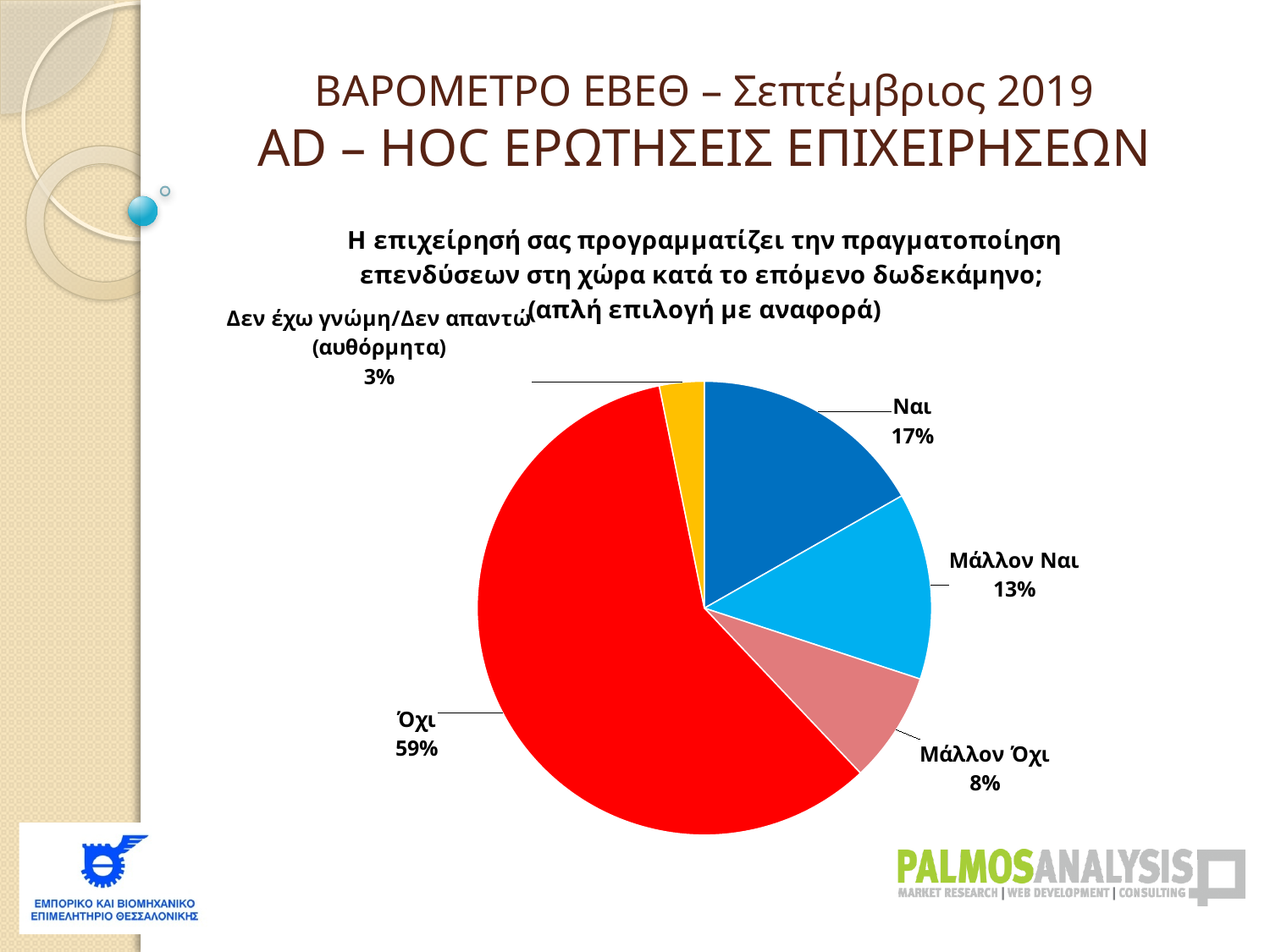
Which response has the smallest share of the pie? Δεν έχω γνώμη/Δεν απαντώ (αυθόρμητα) What percentage of respondents answered 'Μάλλον Όχι'? 8% Which response has the largest share of the pie? Όχι What is the difference in percentage points between 'Όχι' and 'Ναι'? 42 How many slices does the pie chart have? 5 What percentage of respondents answered 'Δεν έχω γνώμη/Δεν απαντώ (αυθόρμητα)'? 3% Which is larger, the share for 'Μάλλον Ναι' or the share for 'Μάλλον Όχι'? Μάλλον Ναι What colour is the 'Όχι' slice? red What kind of chart is shown on the slide? pie chart What percentage of respondents answered 'Μάλλον Ναι'? 13% What percentage of respondents answered 'Ναι'? 17% What percentage of respondents answered 'Όχι'? 59%